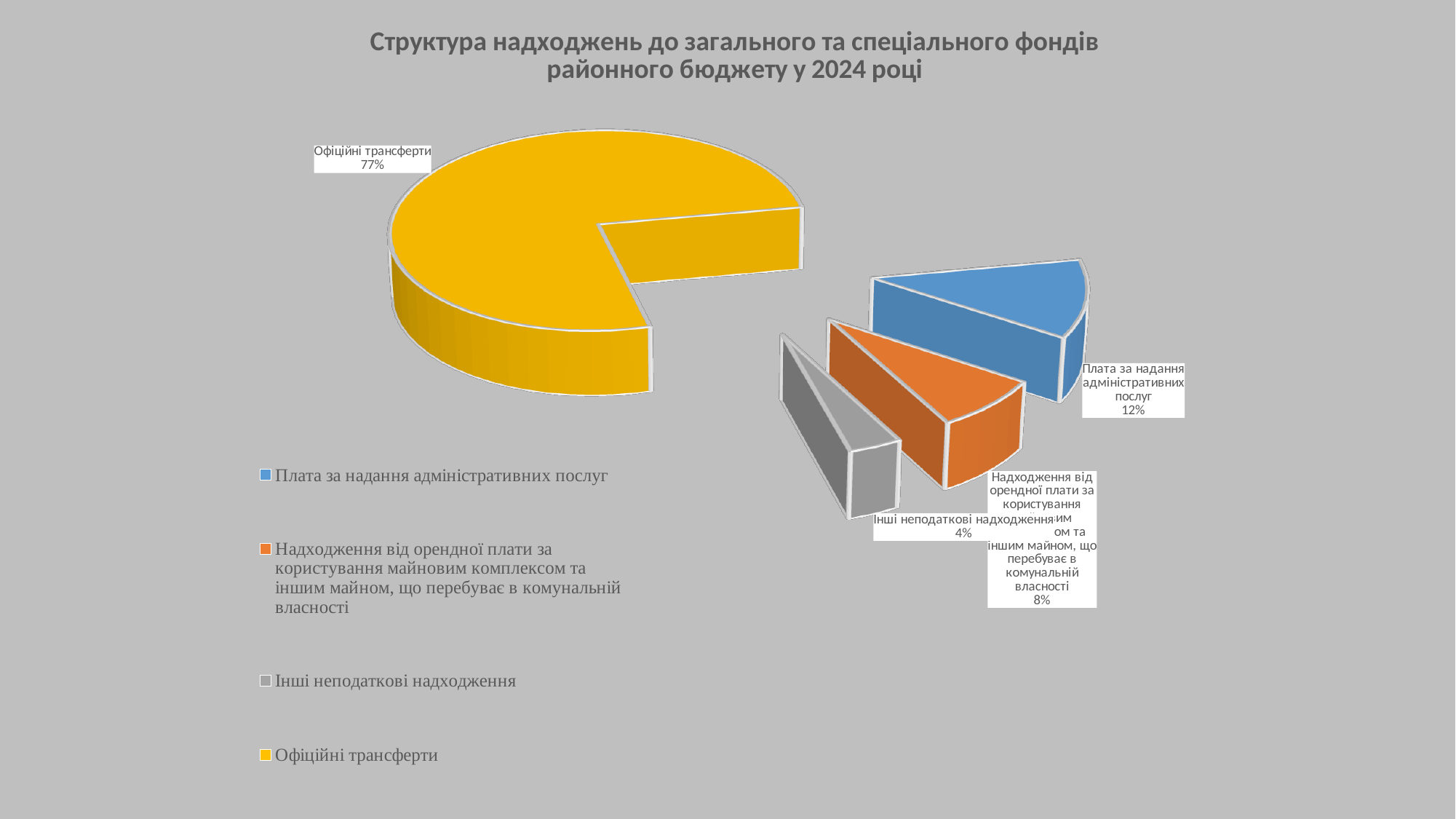
What share of the pie does Інші неподаткові надходження hold? 4% What is the title of the chart? Структура надходжень до загального та спеціального фондів районного бюджету у 2024 році What share of the pie does Офіційні трансферти hold? 77% What kind of chart is shown on the slide? Pie chart What colour is the slice for Офіційні трансферти? Yellow What share of the pie does Плата за надання адміністративних послуг hold? 12% Which category has the smallest share of the pie? Інші неподаткові надходження How many slices does the pie chart have? 4 Which is larger: the share for Плата за надання адміністративних послуг or the share for Інші неподаткові надходження? Плата за надання адміністративних послуг What is the difference in percentage points between Офіційні трансферти and Плата за надання адміністративних послуг? 65 Which category has the largest share of the pie? Офіційні трансферти